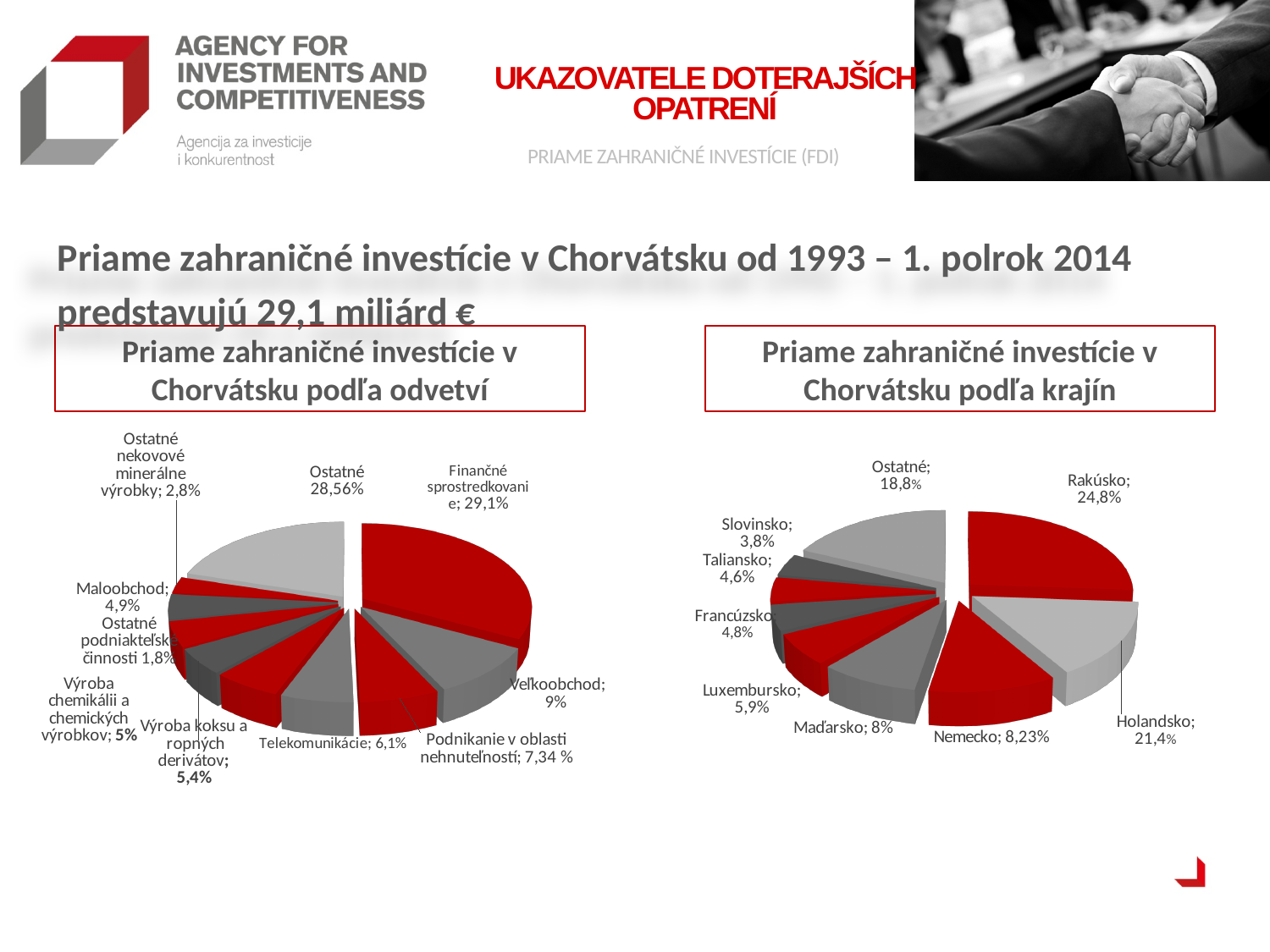
In the chart 'Priame zahraničné investície v Chorvátsku podľa krajín', which named country has the largest share? Rakúsko In the chart 'Priame zahraničné investície v Chorvátsku podľa krajín', what share does Rakúsko have? 24,8% In the chart 'Priame zahraničné investície v Chorvátsku podľa odvetví', what share does Veľkoobchod have? 9% In the chart 'Priame zahraničné investície v Chorvátsku podľa krajín', what share does Holandsko have? 21,4% In the chart 'Priame zahraničné investície v Chorvátsku podľa krajín', which country has the smallest share? Slovinsko What type of chart is 'Priame zahraničné investície v Chorvátsku podľa odvetví'? Pie chart In the chart 'Priame zahraničné investície v Chorvátsku podľa krajín', what is the difference in percentage points between Rakúsko and Holandsko? 3,4 In the chart 'Priame zahraničné investície v Chorvátsku podľa odvetví', what share does Finančné sprostredkovanie have? 29,1% In the chart 'Priame zahraničné investície v Chorvátsku podľa odvetví', which is larger: Telekomunikácie or Maloobchod? Telekomunikácie In the chart 'Priame zahraničné investície v Chorvátsku podľa krajín', how many slices does the pie have? 9 In the chart 'Priame zahraničné investície v Chorvátsku podľa odvetví', which sector has the smallest share? Ostatné podnikateľské činnosti In the chart 'Priame zahraničné investície v Chorvátsku podľa krajín', what share does Nemecko have? 8,23%